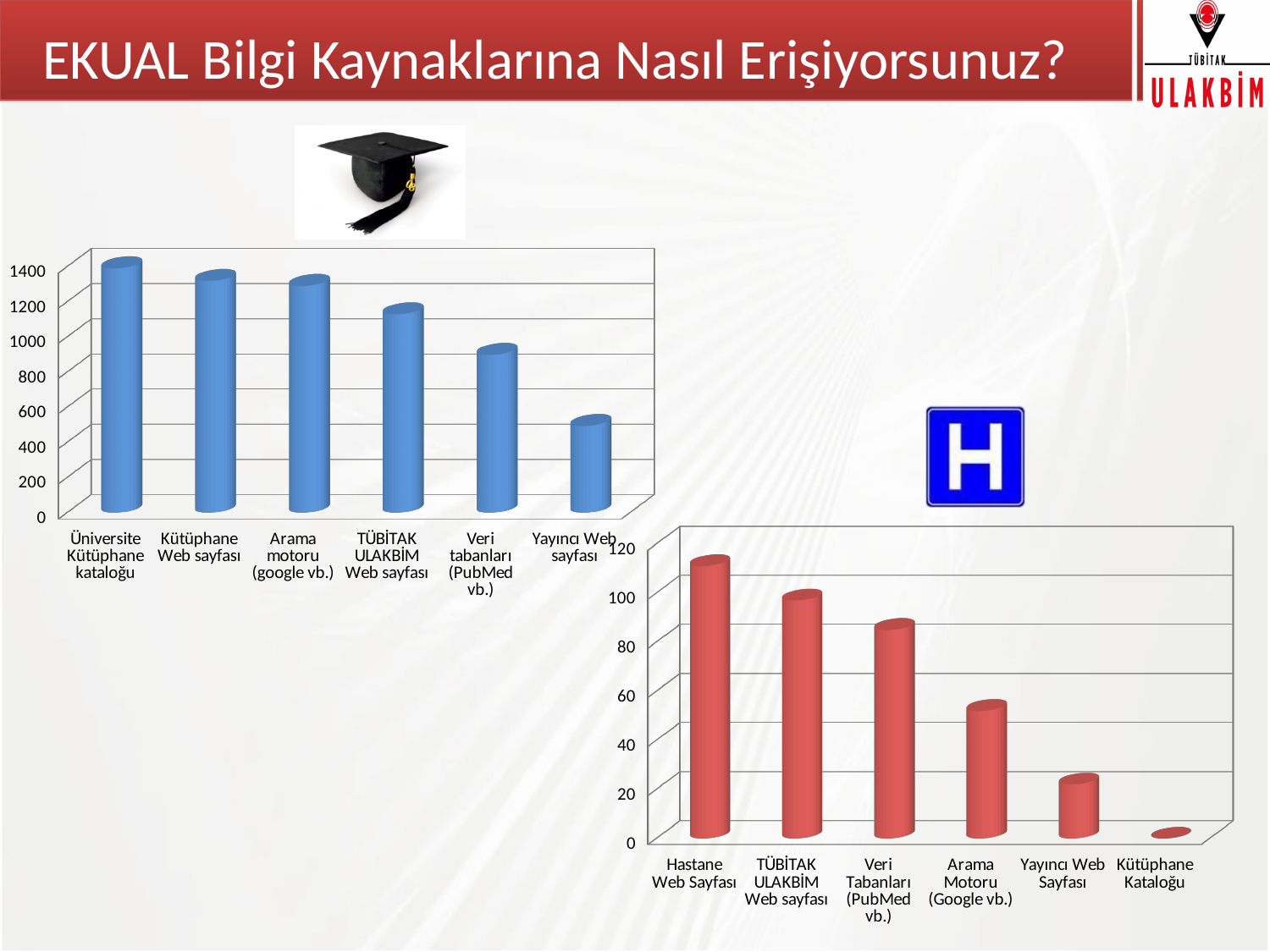
On the right chart (red bars), which category has the highest value? Hastane Web Sayfası On the left chart (blue bars), do the values rise or fall from left to right along the x axis? fall On the right chart (red bars), is the value for Arama Motoru (Google vb.) greater or less than 40? greater What kind of chart is the left chart (blue bars)? bar chart On the right chart (red bars), which category has the lowest value? Kütüphane Kataloğu On the left chart (blue bars), is the value for TÜBİTAK ULAKBİM Web sayfası greater or less than 1000? greater On the left chart (blue bars), is the value for Yayıncı Web sayfası greater or less than 600? less On the left chart (blue bars), which category has the lowest value? Yayıncı Web sayfası How many categories are shown on the right chart (red bars)? 6 How many categories are shown on the left chart (blue bars)? 6 On the left chart (blue bars), which category has the highest value? Üniversite Kütüphane kataloğu On the right chart (red bars), which is larger: Veri Tabanları (PubMed vb.) or Yayıncı Web Sayfası? Veri Tabanları (PubMed vb.)